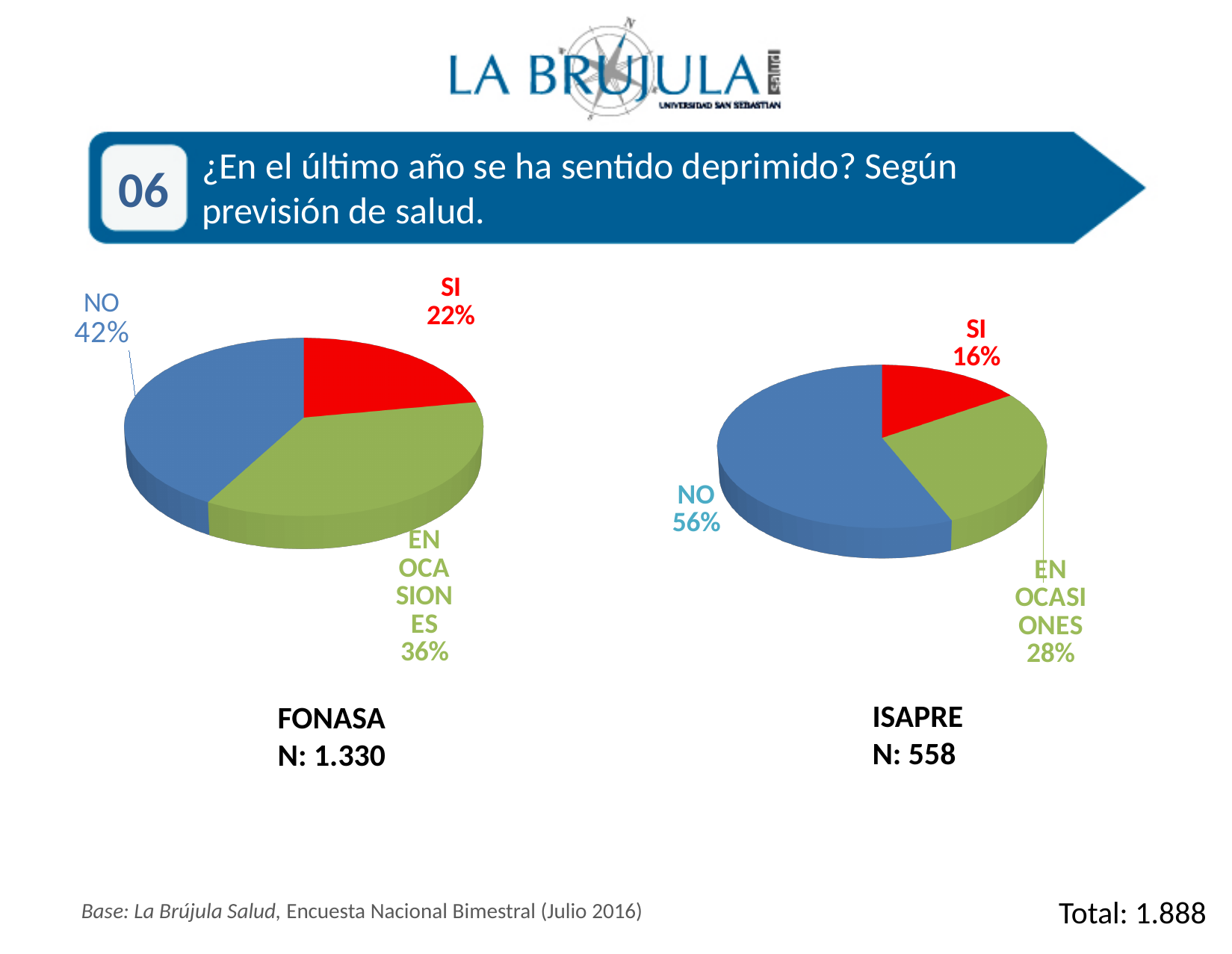
What is the sample size (N) shown under the ISAPRE chart? 558 What type of chart is used for the FONASA data? Pie chart In the FONASA pie chart, what is the difference between the NO and SI percentages? 20% In the ISAPRE pie chart, what percentage is shown for NO? 56% What colour is the EN OCASIONES slice in the FONASA pie chart? Green Which is larger: the SI share in the FONASA chart or the SI share in the ISAPRE chart? FONASA In the FONASA pie chart, what percentage is shown for NO? 42% In the ISAPRE pie chart, what percentage is shown for EN OCASIONES? 28% In the FONASA pie chart, what percentage is shown for SI? 22% In the ISAPRE pie chart, which category has the smallest share? SI In the FONASA pie chart, which category has the largest share? NO How many slices does the ISAPRE pie chart have? 3